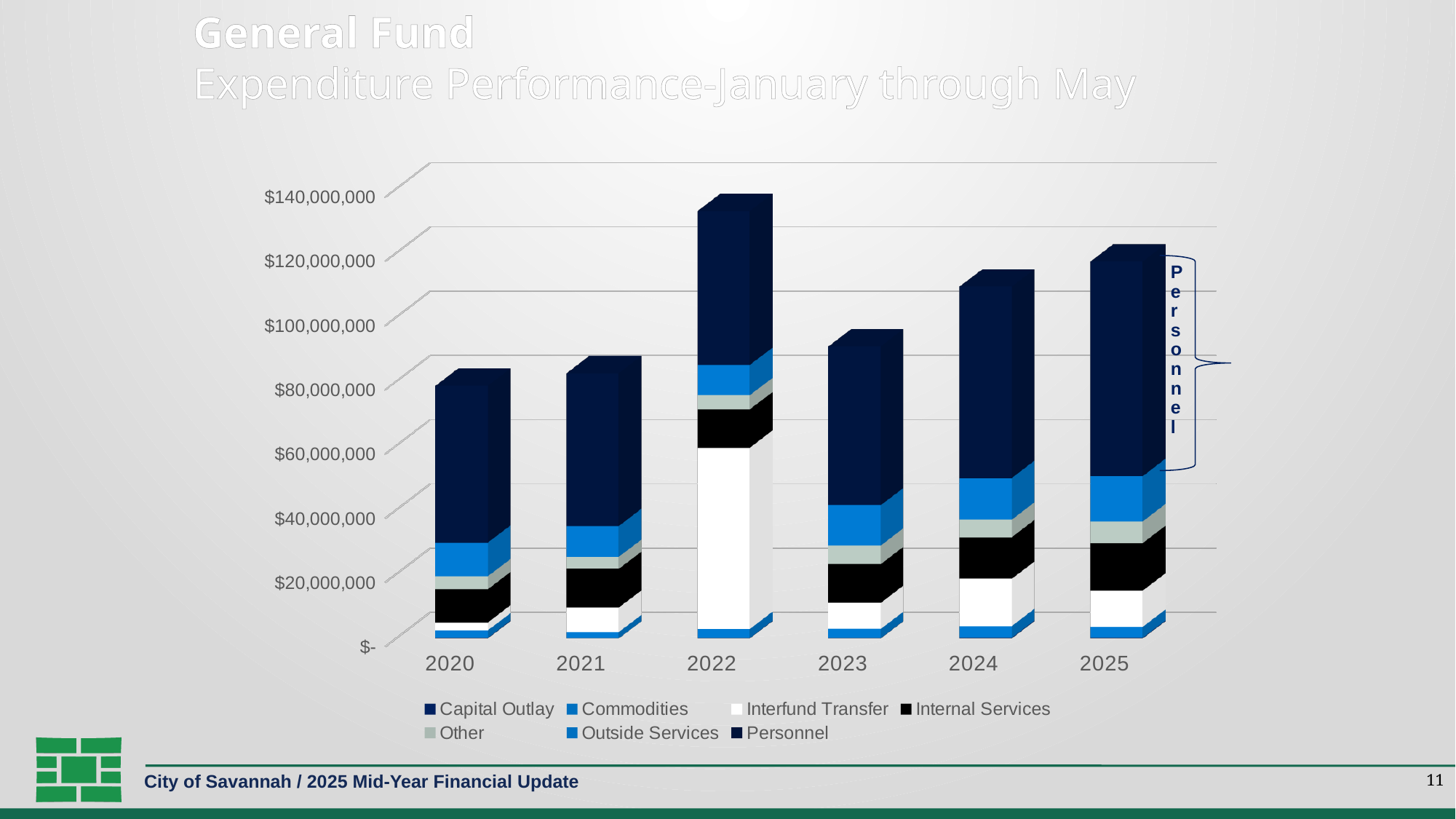
Which year has the highest total expenditure bar? 2022 Is the total expenditure bar for 2023 greater or less than $100,000,000? less Is the total expenditure bar for 2024 greater or less than $100,000,000? greater Which series is labelled with a bracket beside the 2025 bar? Personnel Which year has the larger total expenditure bar, 2022 or 2023? 2022 How many series does the chart's legend list? 7 What kind of chart is shown on the slide? Stacked bar chart Is the total expenditure bar for 2022 greater or less than $120,000,000? greater How many years are shown along the x axis of the chart? 6 Do the total expenditure bars rise or fall from 2023 to 2025? rise In which year is the Interfund Transfer segment the largest? 2022